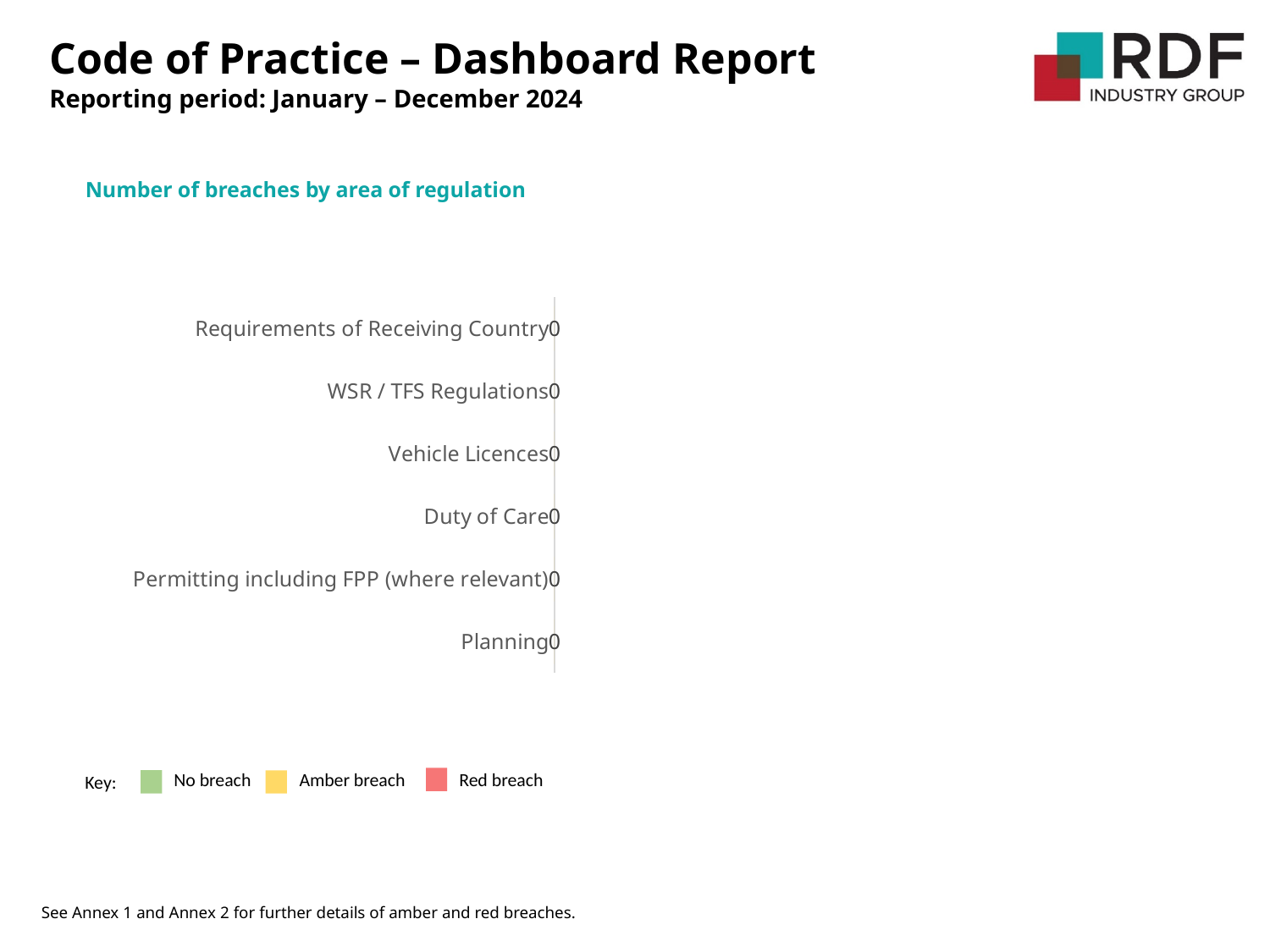
What is the number of breaches for Permitting including FPP (where relevant)? 0 What is the number of breaches for Duty of Care? 0 What is the difference between the number of breaches for Planning and for Duty of Care? 0 What is the number of breaches for WSR / TFS Regulations? 0 What is the title of the chart? Number of breaches by area of regulation How many entries does the key below the chart list? 3 Which colour does the key use for Amber breach? Yellow How many areas of regulation are listed in the chart? 6 What is the number of breaches for Requirements of Receiving Country? 0 What is the number of breaches for Planning? 0 What is the number of breaches for Vehicle Licences? 0